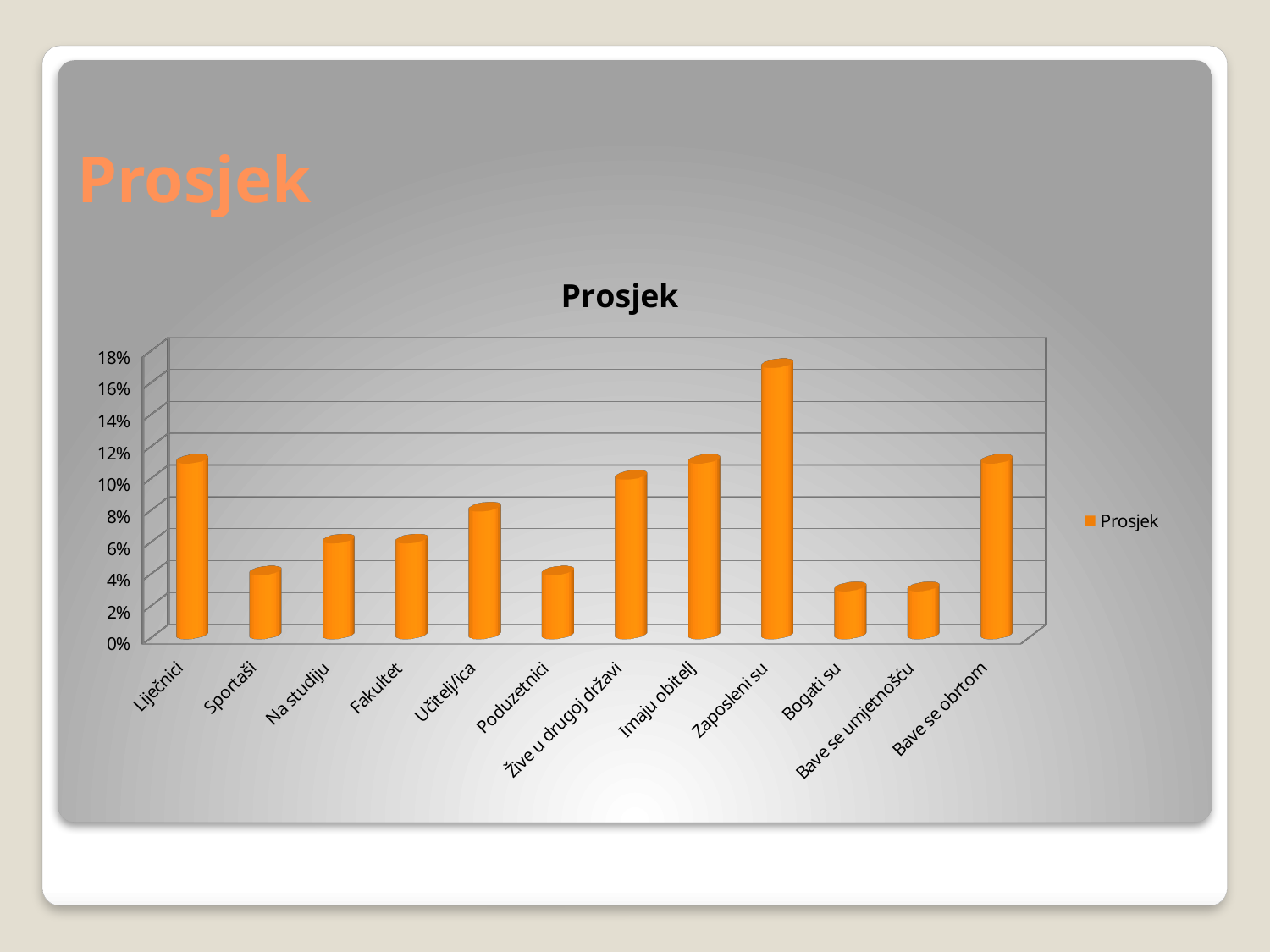
Is the value for Liječnici greater or less than 10%? greater Which category has the highest value in the chart? Zaposleni su What kind of chart is shown on the slide? bar chart Is the value for Bogati su greater or less than 4%? less What is the title of the chart? Prosjek Which is larger, the value for Imaju obitelj or the value for Bave se umjetnošću? Imaju obitelj Is the value for Sportaši greater or less than 6%? less How many categories are shown on the x axis of the chart? 12 Which is larger, the value for Učitelj/ica or the value for Poduzetnici? Učitelj/ica How many series does the legend list? 1 What colour are the bars in the chart? orange